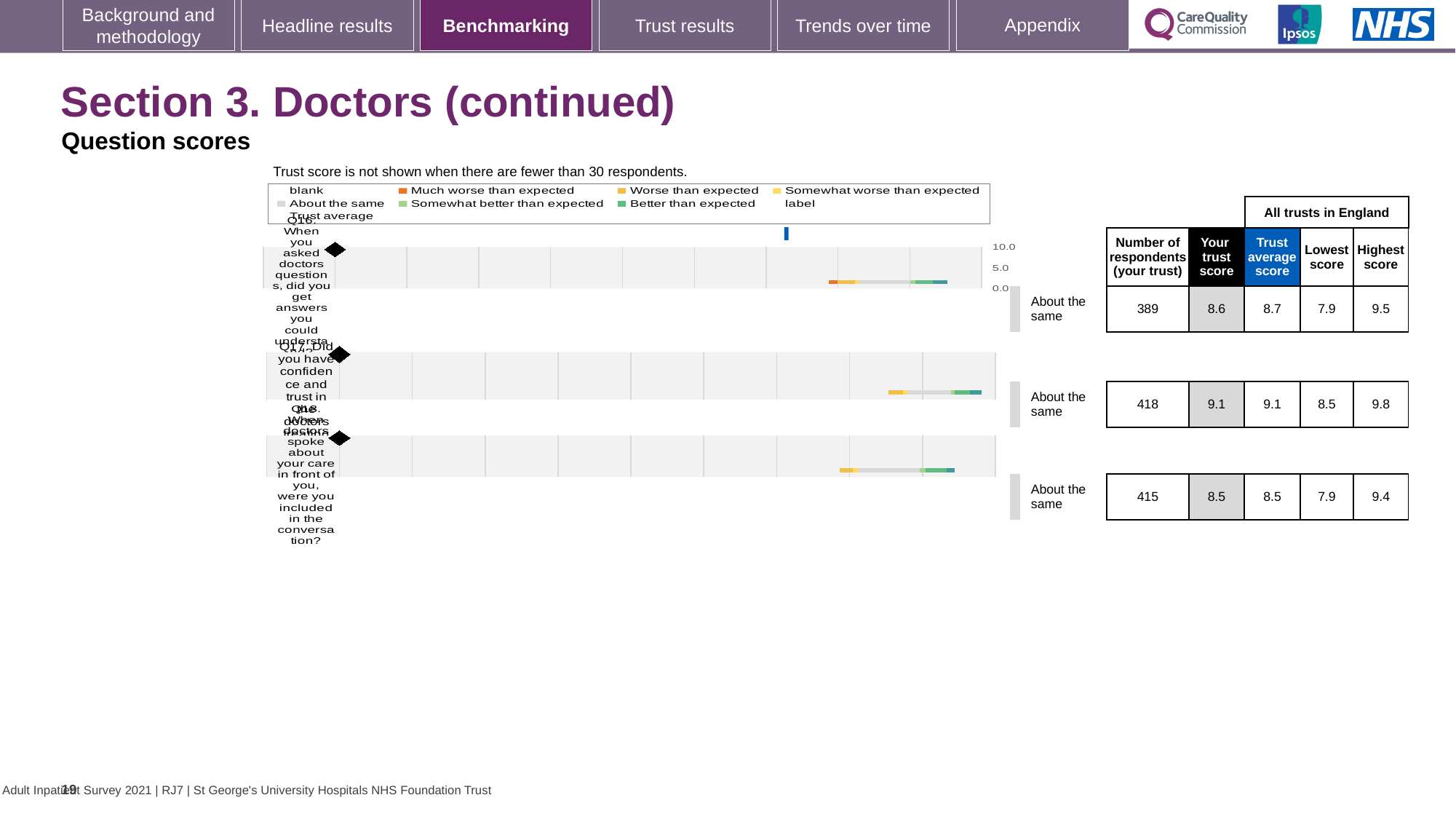
What is the trust average score for Q18? 8.5 What is your trust score for Q17? 9.1 Which question has the highest 'Your trust score'? Q17 What is the highest score across all trusts in England for Q17? 9.8 What kind of chart is used to show the question scores? bar chart Which question has the lowest 'Your trust score'? Q18 What is the difference between the highest score and the lowest score for Q16? 1.6 How many questions are plotted on the chart? 3 What benchmark category label is shown for all three questions? About the same For Q16, which is larger: your trust score or the trust average score? Trust average score What is the lowest score across all trusts in England for Q16? 7.9 What is the number of respondents (your trust) for Q16? 389